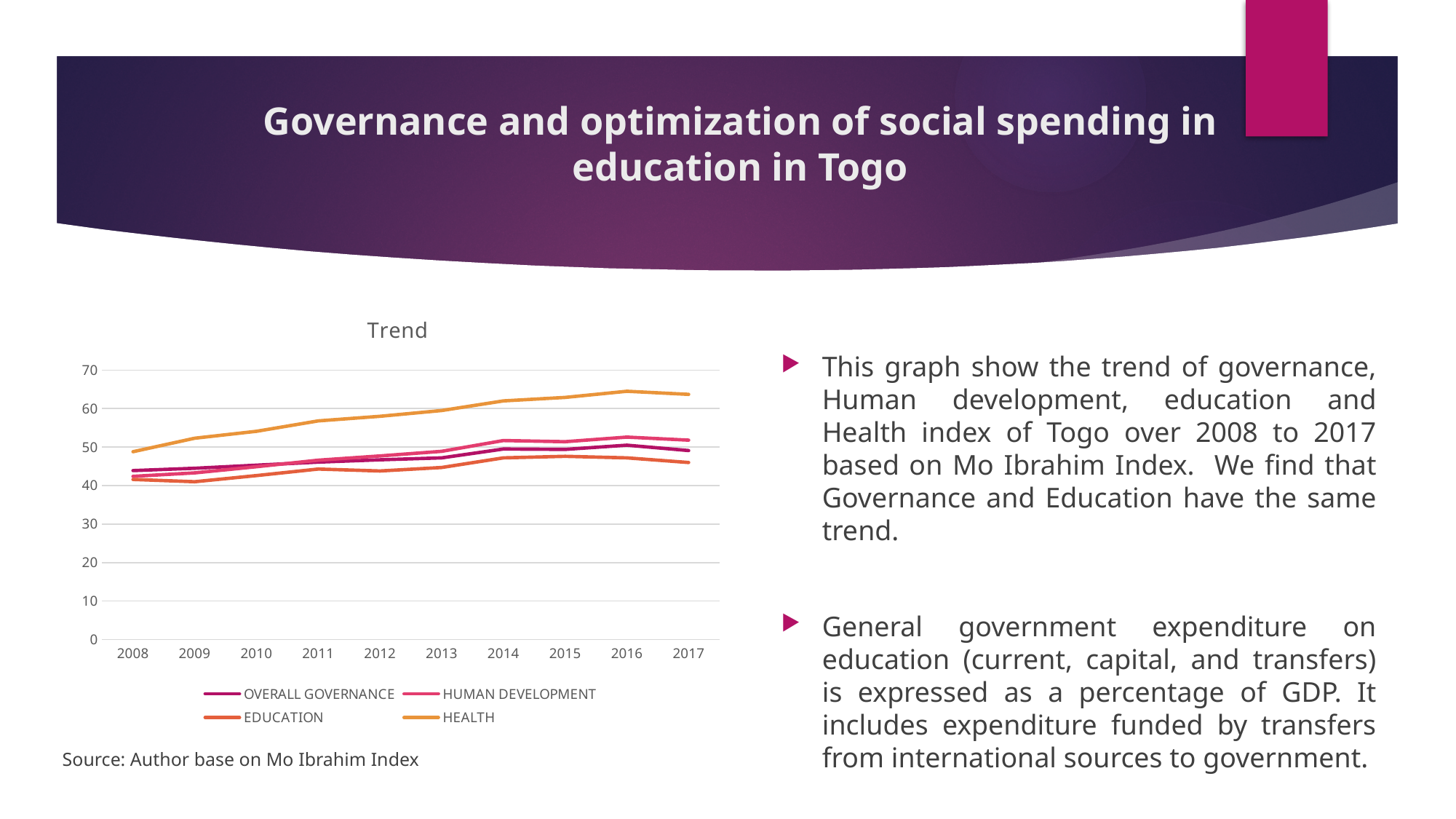
Is the value for HEALTH in 2017 greater or less than 60? greater Is the value for HEALTH in 2008 greater or less than 50? less How many years are shown on the x axis of the chart? 10 What is the title of the chart? Trend Is the value for EDUCATION in 2008 greater or less than 50? less Which series is drawn in orange in the chart? HEALTH Which series has the lowest value in 2017? EDUCATION How many series does the legend of the chart list? 4 What kind of chart is shown on the slide? line chart Does the HEALTH series generally rise or fall from 2008 to 2017? rise Which series has the highest values across the chart? HEALTH In 2017, which is larger: the value for HEALTH or the value for EDUCATION? HEALTH